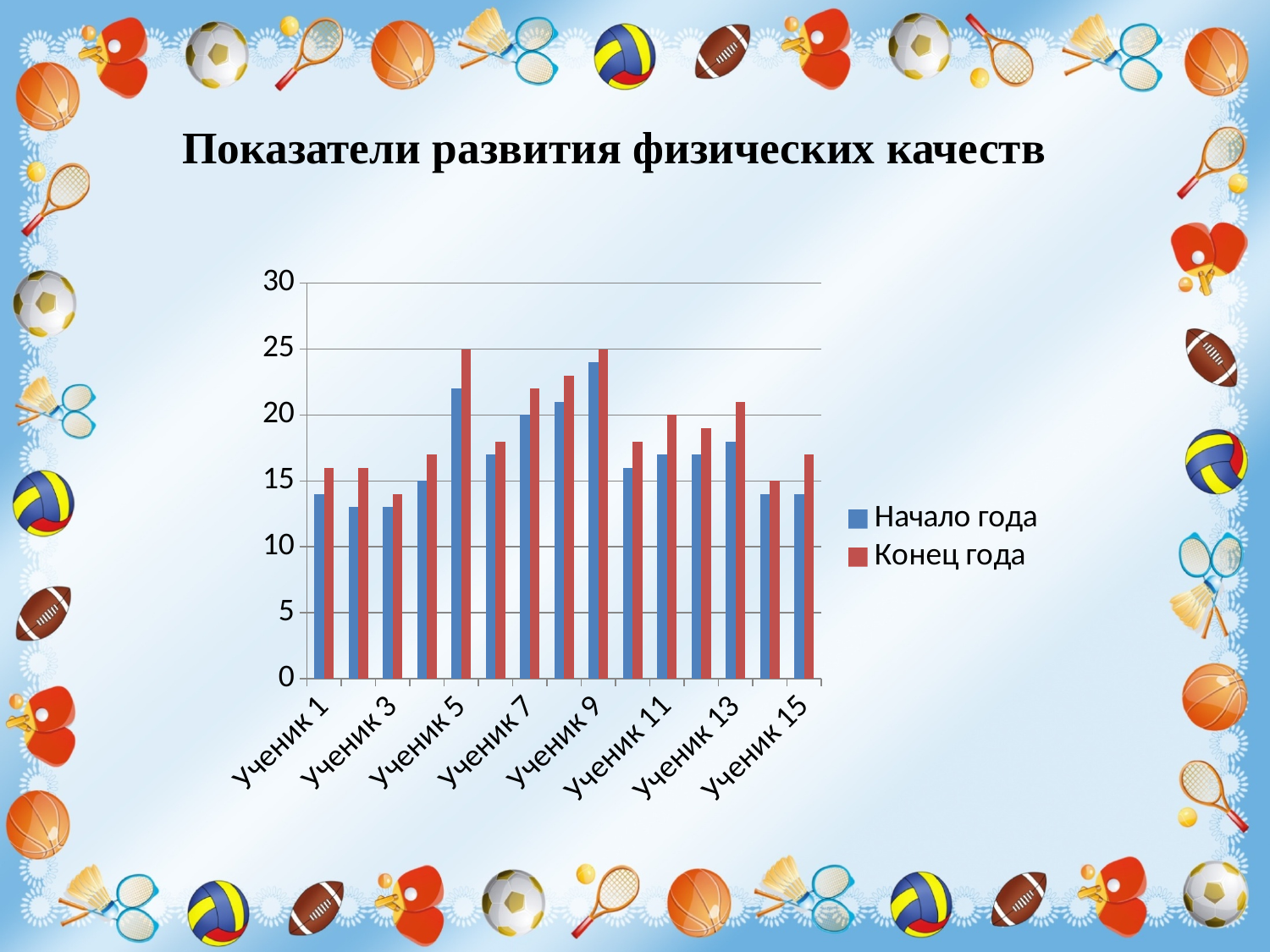
Which colour represents the series 'Конец года'? red What kind of chart is shown on the slide? bar chart What is the title of the chart? Показатели развития физических качеств For Ученик 5, which is larger: the 'Начало года' value or the 'Конец года' value? Конец года What is the 'Конец года' value for Ученик 5? 25 Is the 'Конец года' value for Ученик 13 greater or less than 20? greater Is the 'Начало года' value for Ученик 1 greater or less than 15? less What is the 'Конец года' value for Ученик 11? 20 How many series does the legend list? 2 Which student has the highest 'Начало года' value? Ученик 9 How many students (categories) are plotted on the x axis? 15 What is the 'Начало года' value for Ученик 7? 20